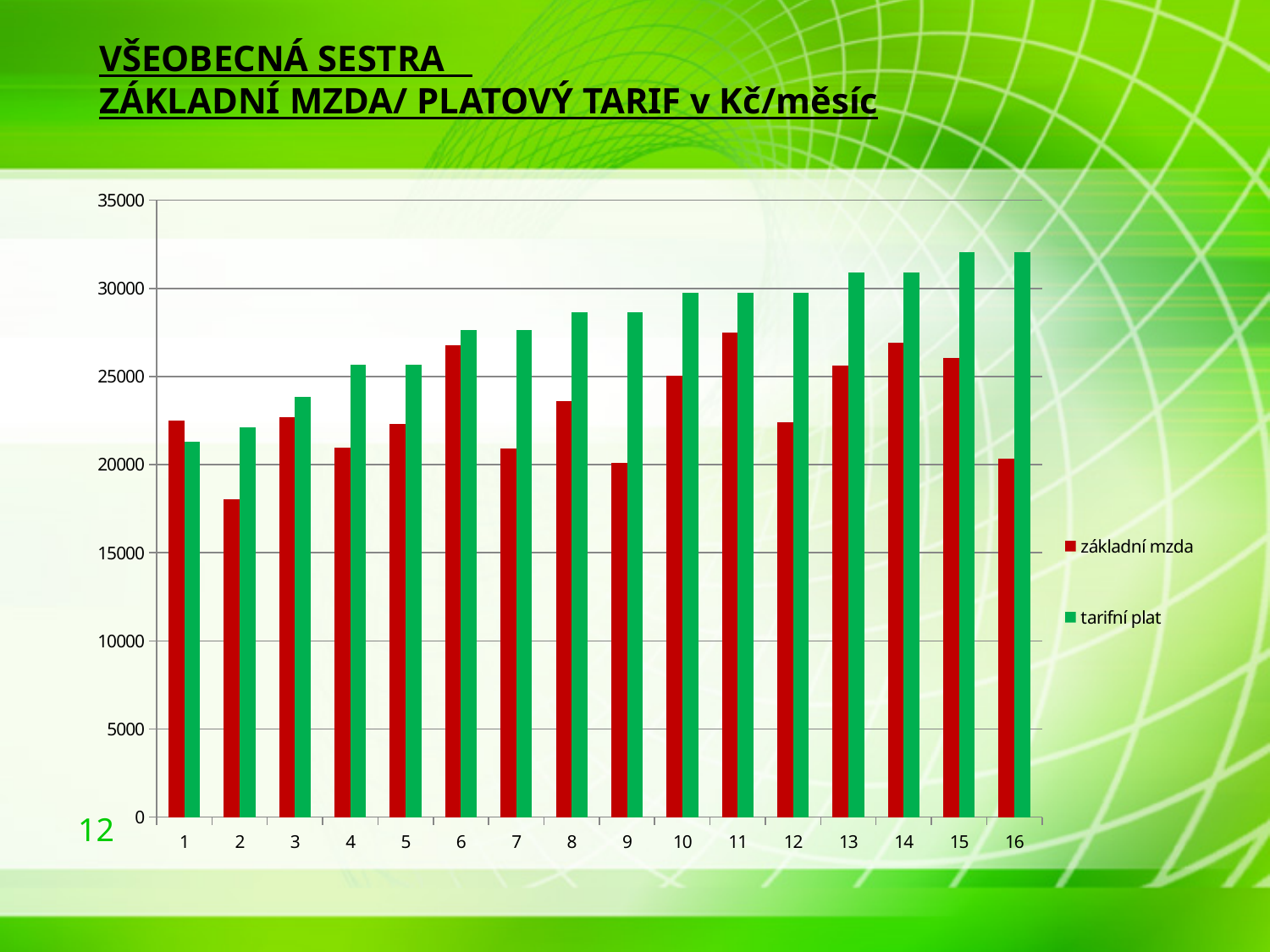
Which category has the lowest value for základní mzda? 2 Is the value of tarifní plat for category 1 greater or less than 25000? less What kind of chart is shown on the slide? bar chart How many series does the legend list? 2 Is the value of základní mzda for category 11 greater or less than 25000? greater How many categories are shown on the x axis? 16 Is the value of tarifní plat for category 16 greater or less than 30000? greater Which colour represents tarifní plat in the chart? green Does the tarifní plat series generally rise or fall from category 1 to category 16? rise For category 16, which series has the larger value, základní mzda or tarifní plat? tarifní plat Which category has the lowest value for tarifní plat? 1